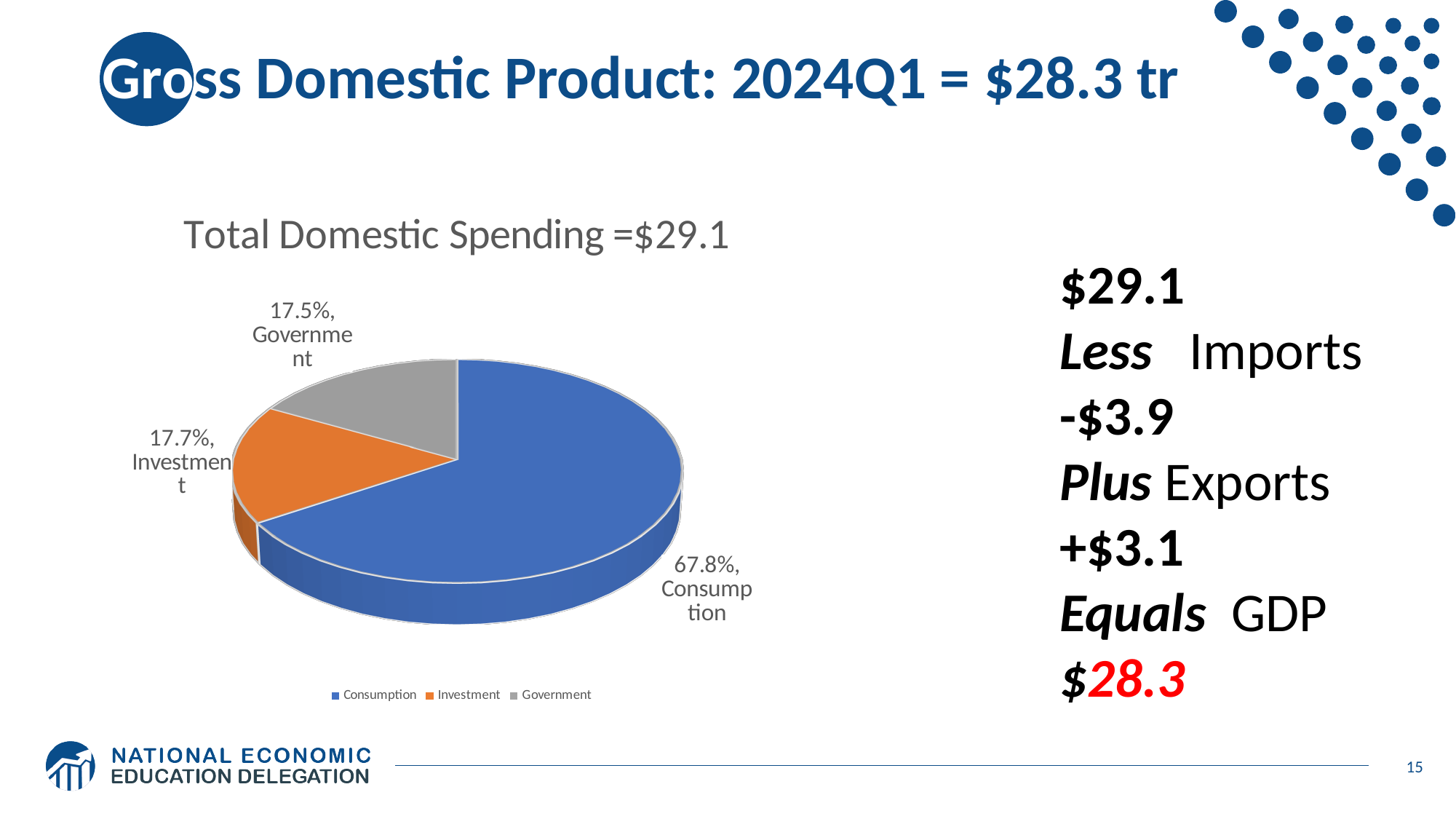
What share of the pie does Consumption represent? 67.8% What is the difference in percentage points between the Consumption and Investment slices? 50.1% Which category has the largest slice of the pie? Consumption How many entries does the legend list? 3 How many slices does the pie chart have? 3 What kind of chart is shown on the slide? Pie chart What share of the pie does Investment represent? 17.7% What is the title of the chart? Total Domestic Spending =$29.1 What is the difference in percentage points between the Investment and Government slices? 0.2% What share of the pie does Government represent? 17.5% Which is larger, the Consumption slice or the Government slice? Consumption Which category has the smallest slice of the pie, according to the printed labels? Government